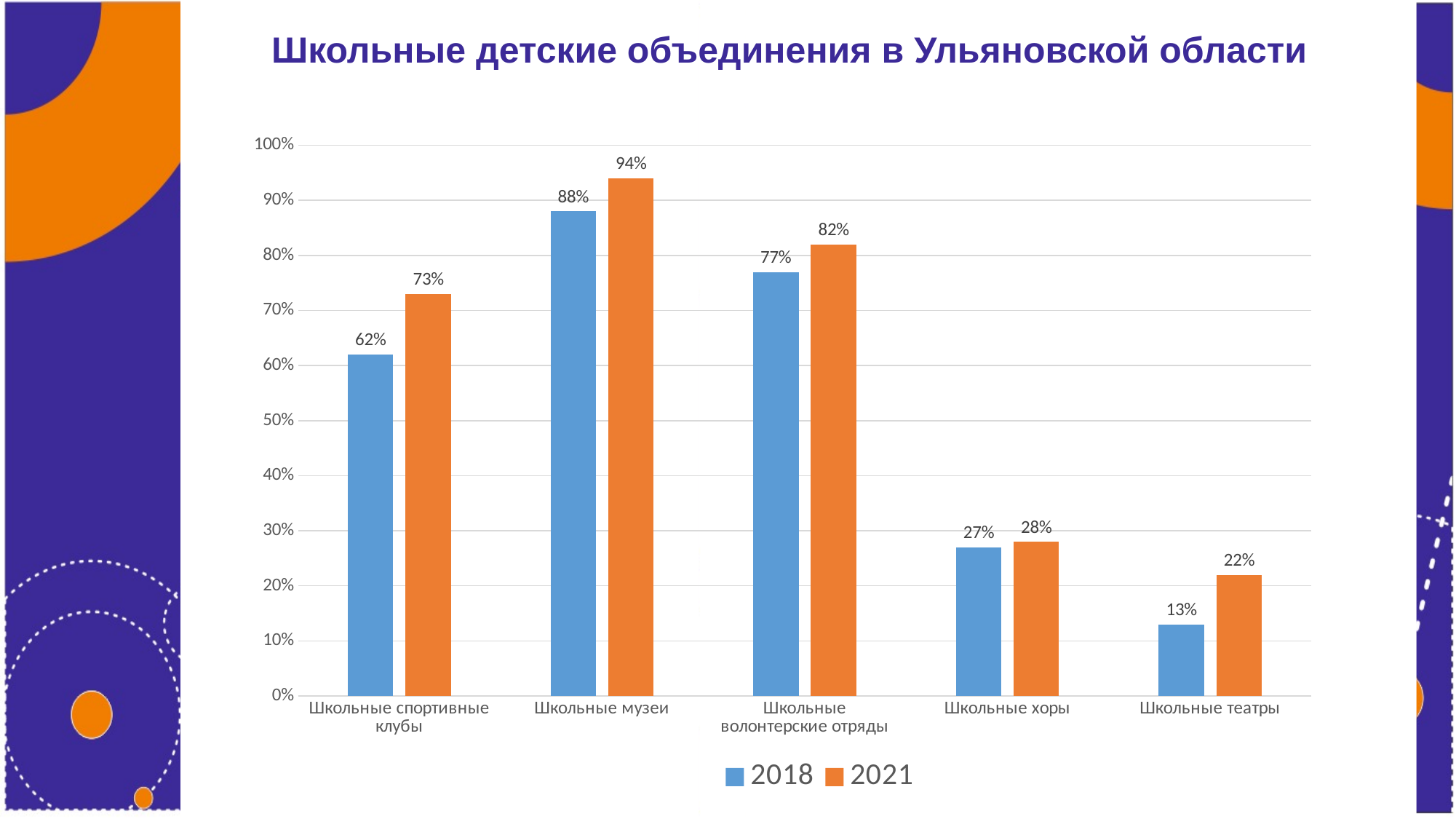
Which category has the lowest value in 2018? Школьные театры Which category has the highest value in 2021? Школьные музеи What is the difference between the 2021 and 2018 values for Школьные спортивные клубы? 11% What is the value for Школьные музеи in 2021? 94% How many series does the legend list? 2 Is the 2021 value for Школьные волонтерские отряды greater or less than 80%? greater What is the title of the chart? Школьные детские объединения в Ульяновской области What kind of chart is shown on the slide? bar chart Which is larger: the 2018 value for Школьные хоры or the 2018 value for Школьные театры? Школьные хоры What is the value for Школьные волонтерские отряды in 2018? 77% How many categories are shown on the x axis? 5 What is the value for Школьные театры in 2018? 13%